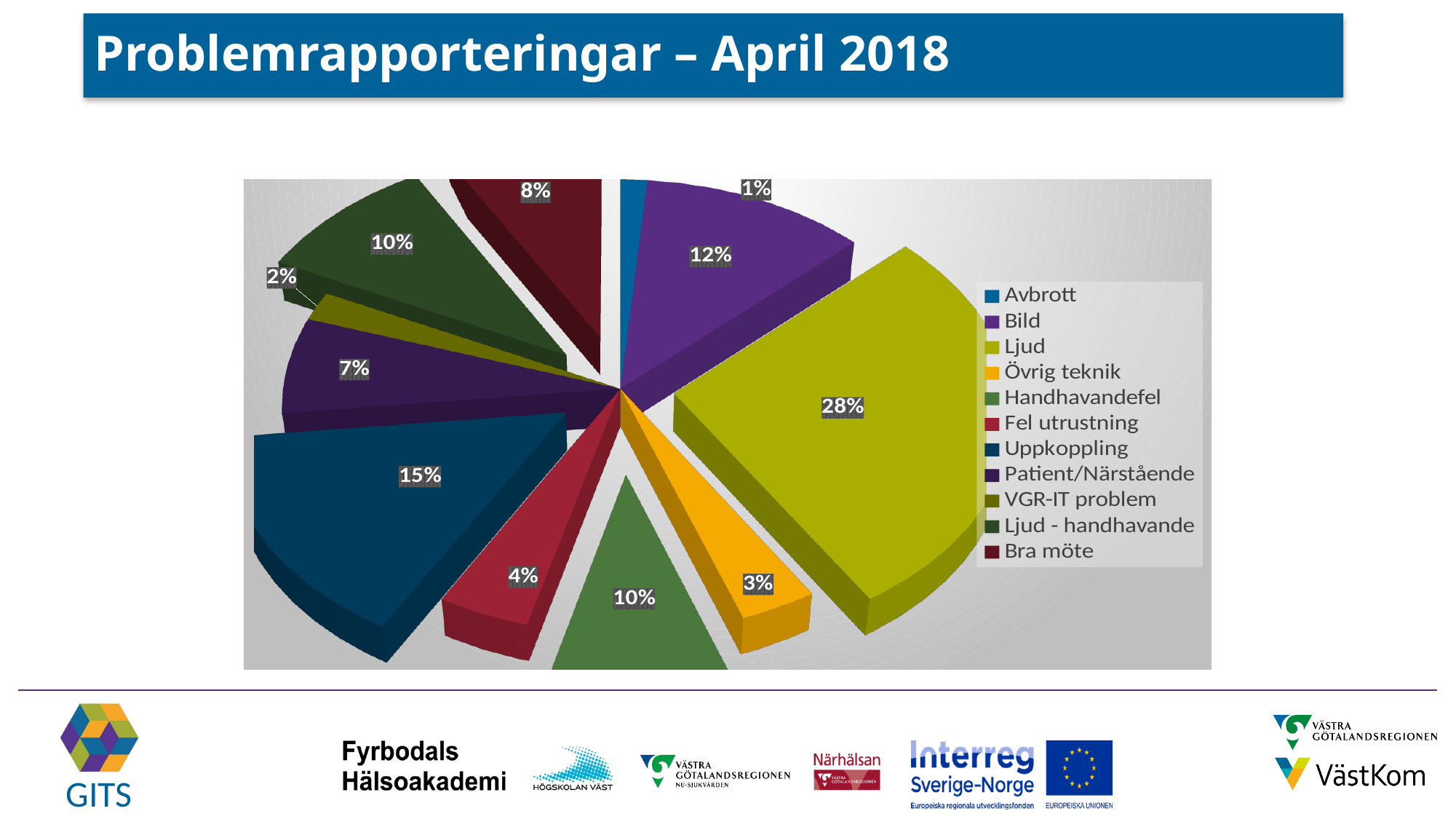
What type of chart is shown on the slide? Pie chart Which is larger, Bild or Handhavandefel? Bild Which category has the largest slice of the pie? Ljud What percentage is shown for Patient/Närstående? 7% How many categories does the pie chart show? 11 What percentage is shown for Bild? 12% What percentage is shown for Bra möte? 8% What percentage is shown for Uppkoppling? 15% What share of problem reports does Ljud account for? 28% How many percentage points larger is Ljud than Uppkoppling? 13 Which category has the smallest slice of the pie? Avbrott What is the title of the slide? Problemrapporteringar – April 2018